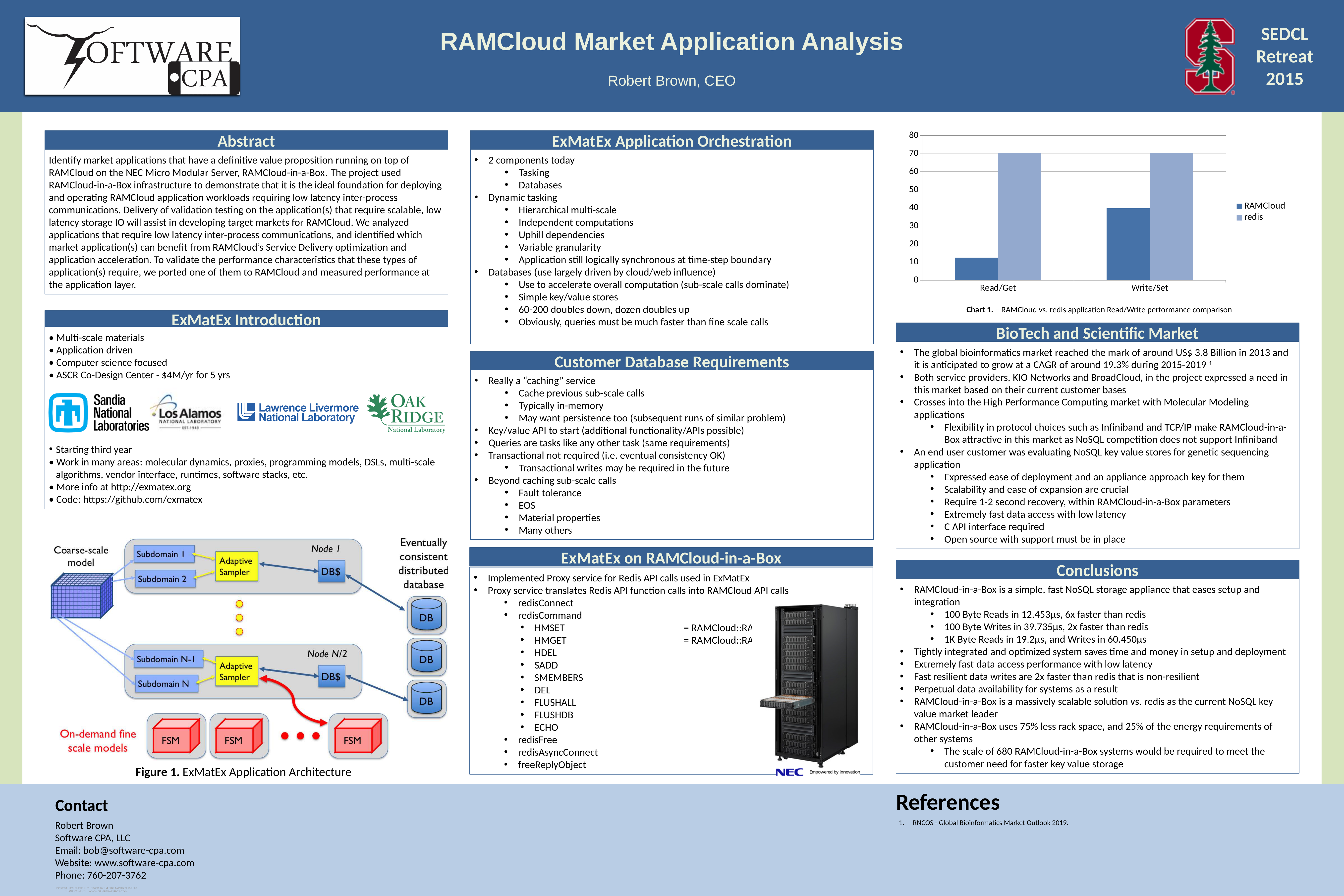
What kind of chart is Chart 1 on the slide? bar chart In Chart 1, which bar is the lowest overall? RAMCloud Read/Get In Chart 1, is the redis value for Write/Set greater or less than 60? greater How many categories are shown on the x axis of Chart 1? 2 In Chart 1, is the redis value for Read/Get greater or less than 60? greater In Chart 1, which category has the higher RAMCloud value? Write/Set In Chart 1, which series is listed first in the legend? RAMCloud How many series does the legend of Chart 1 list? 2 In Chart 1, is the RAMCloud value for Read/Get greater or less than 20? less In Chart 1, for Write/Set, which series has the larger value, RAMCloud or redis? redis In Chart 1, for Read/Get, which series has the larger value, RAMCloud or redis? redis